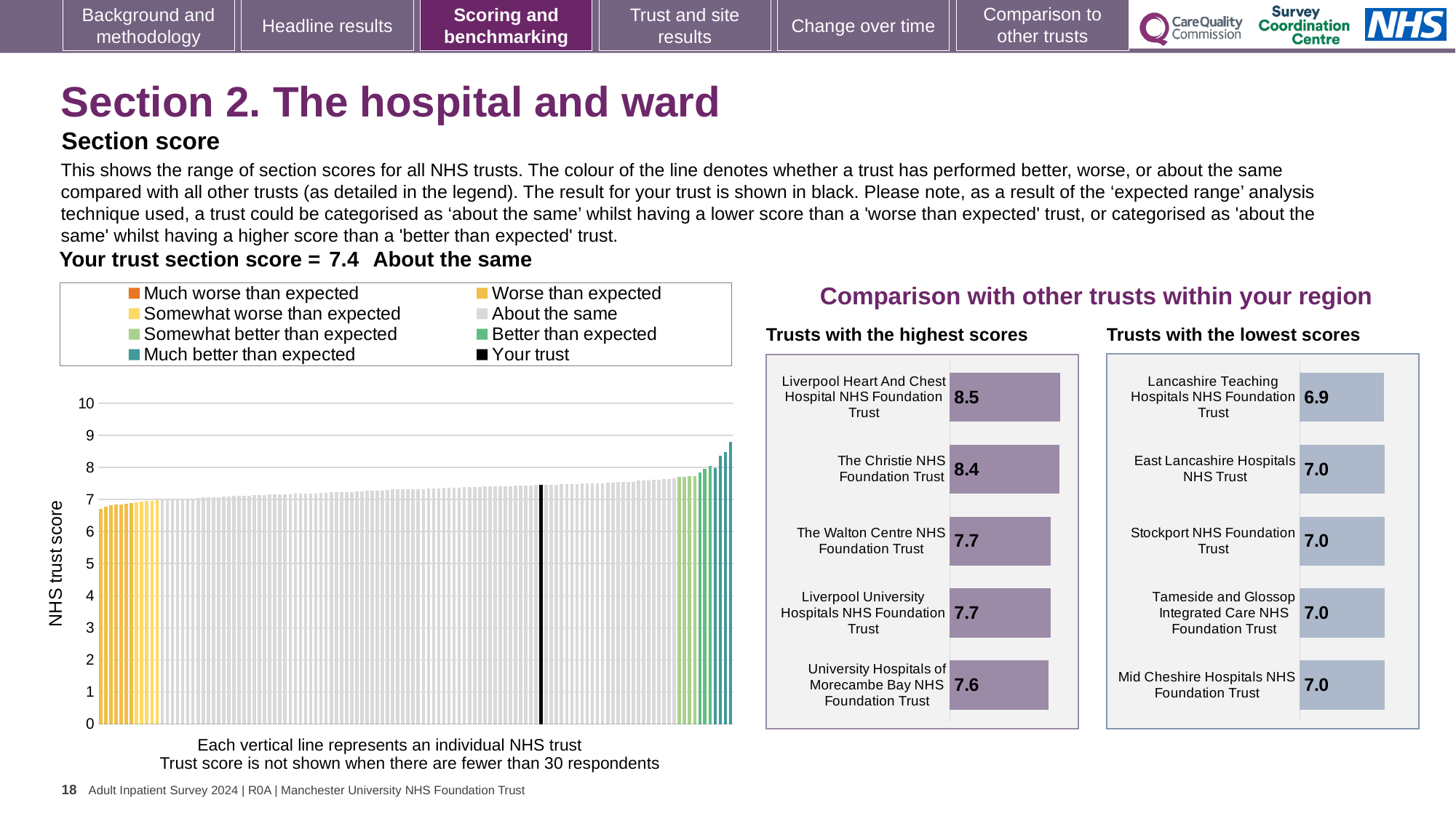
In the 'Trusts with the highest scores' chart, which has the larger score: The Walton Centre NHS Foundation Trust or University Hospitals of Morecambe Bay NHS Foundation Trust? The Walton Centre NHS Foundation Trust In the 'Trusts with the highest scores' chart, which trust has the highest score? Liverpool Heart And Chest Hospital NHS Foundation Trust In the 'Trusts with the lowest scores' chart, which trust has the lowest score? Lancashire Teaching Hospitals NHS Foundation Trust How many entries does the legend above the large chart on the left list? 8 In the 'Trusts with the highest scores' chart, what is the score for The Christie NHS Foundation Trust? 8.4 What kind of chart is the large chart on the left showing NHS trust scores? Bar chart In the large chart on the left, do the trust scores rise or fall from left to right? Rise In the 'Trusts with the lowest scores' chart, what is the score for Stockport NHS Foundation Trust? 7.0 In the 'Trusts with the highest scores' chart, what is the difference between the scores of Liverpool Heart And Chest Hospital NHS Foundation Trust and University Hospitals of Morecambe Bay NHS Foundation Trust? 0.9 In the 'Trusts with the lowest scores' chart, what is the difference between the scores of East Lancashire Hospitals NHS Trust and Lancashire Teaching Hospitals NHS Foundation Trust? 0.1 In the 'Trusts with the highest scores' chart, what is the score for Liverpool Heart And Chest Hospital NHS Foundation Trust? 8.5 How many trusts are shown in the 'Trusts with the highest scores' chart? 5